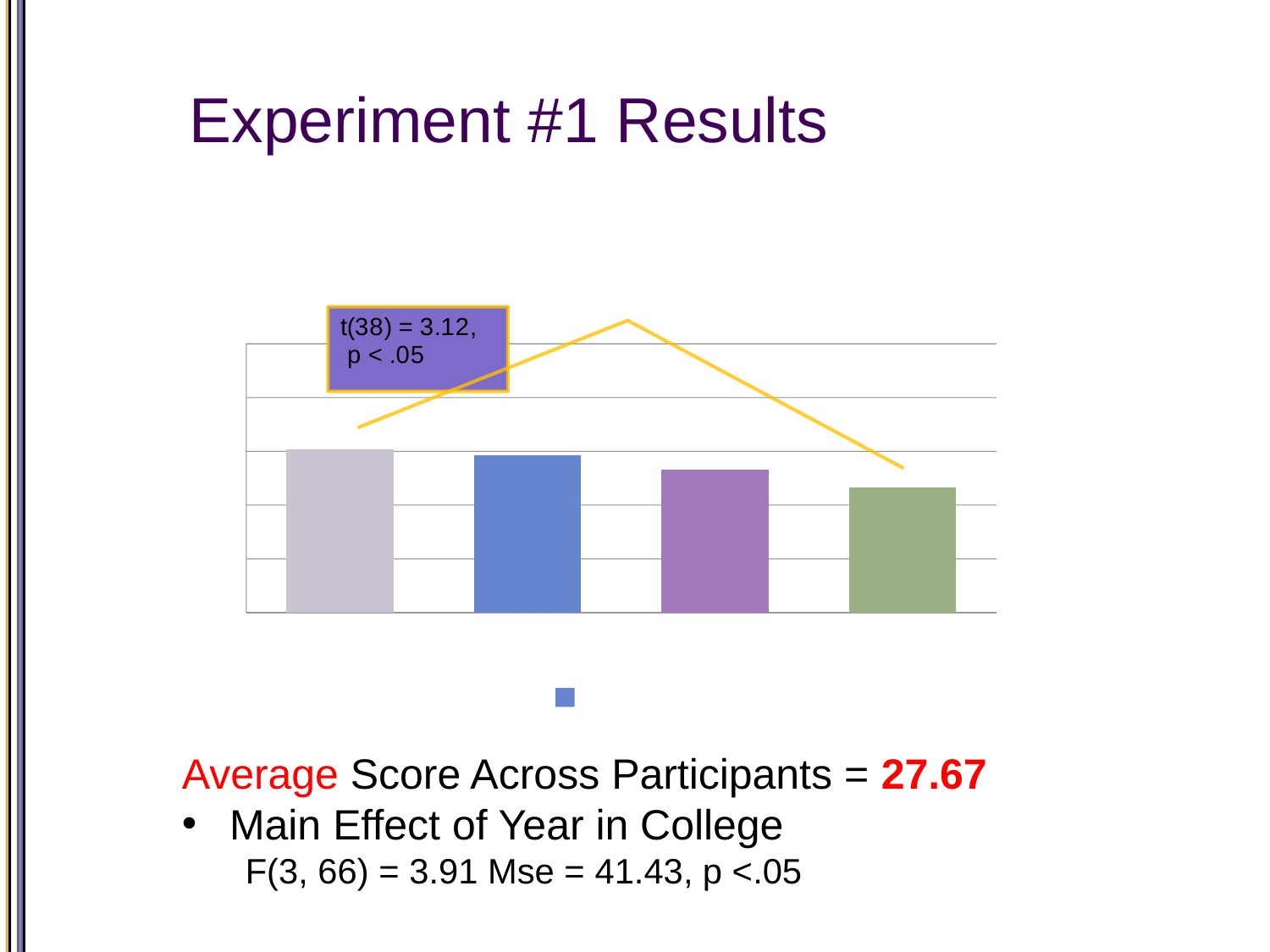
What statistic is printed in the box overlaid on the chart? t(38) = 3.12, p < .05 Which bar is the tallest in the chart: the first (leftmost) or the fourth (rightmost)? the first (leftmost) Which bar is the shortest in the chart: the leftmost or the rightmost? the rightmost What kind of chart is shown on the slide? bar chart Is the leftmost (light purple) bar taller or shorter than the rightmost (green) bar? taller Is the second (blue) bar taller or shorter than the third (purple) bar? taller How many bars are plotted in the chart? 4 What colour is the rightmost bar in the chart? green Do the bar heights rise or fall from left to right across the chart? fall